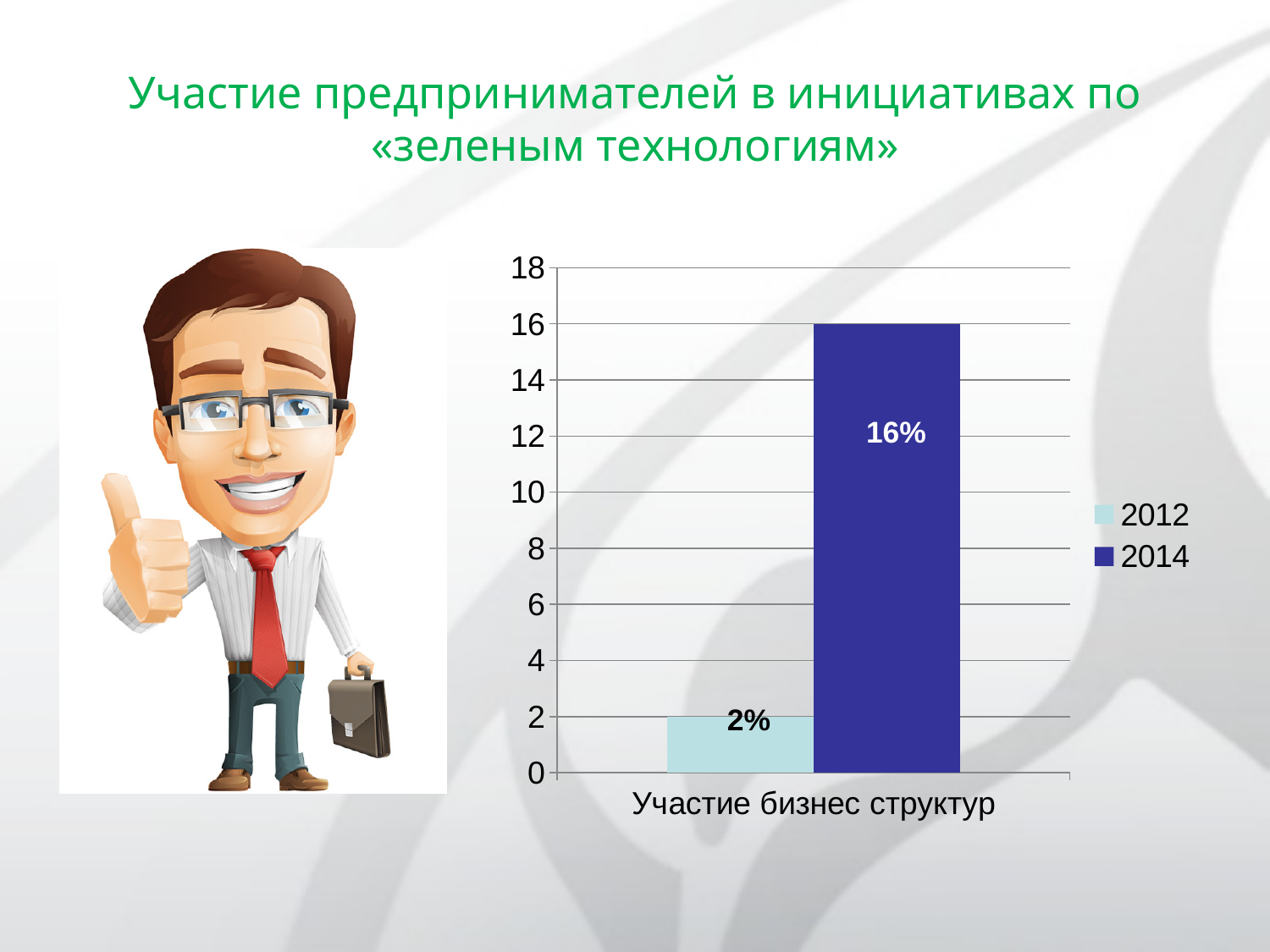
How many series does the legend list? 2 Which series has the lowest value in the chart? 2012 Which series has the higher value, 2012 or 2014? 2014 What is the maximum value shown on the y axis of the chart? 18 What is the value for 2012 in the chart? 2% What kind of chart is shown on the slide? Bar chart What is the difference between the 2014 and 2012 values? 14% What is the value for 2014 in the chart? 16% What is the category label on the x axis of the chart? Участие бизнес структур Is the value for 2014 greater or less than 10? greater How many categories are shown on the x axis? 1 Is the value for 2012 greater or less than 4? less